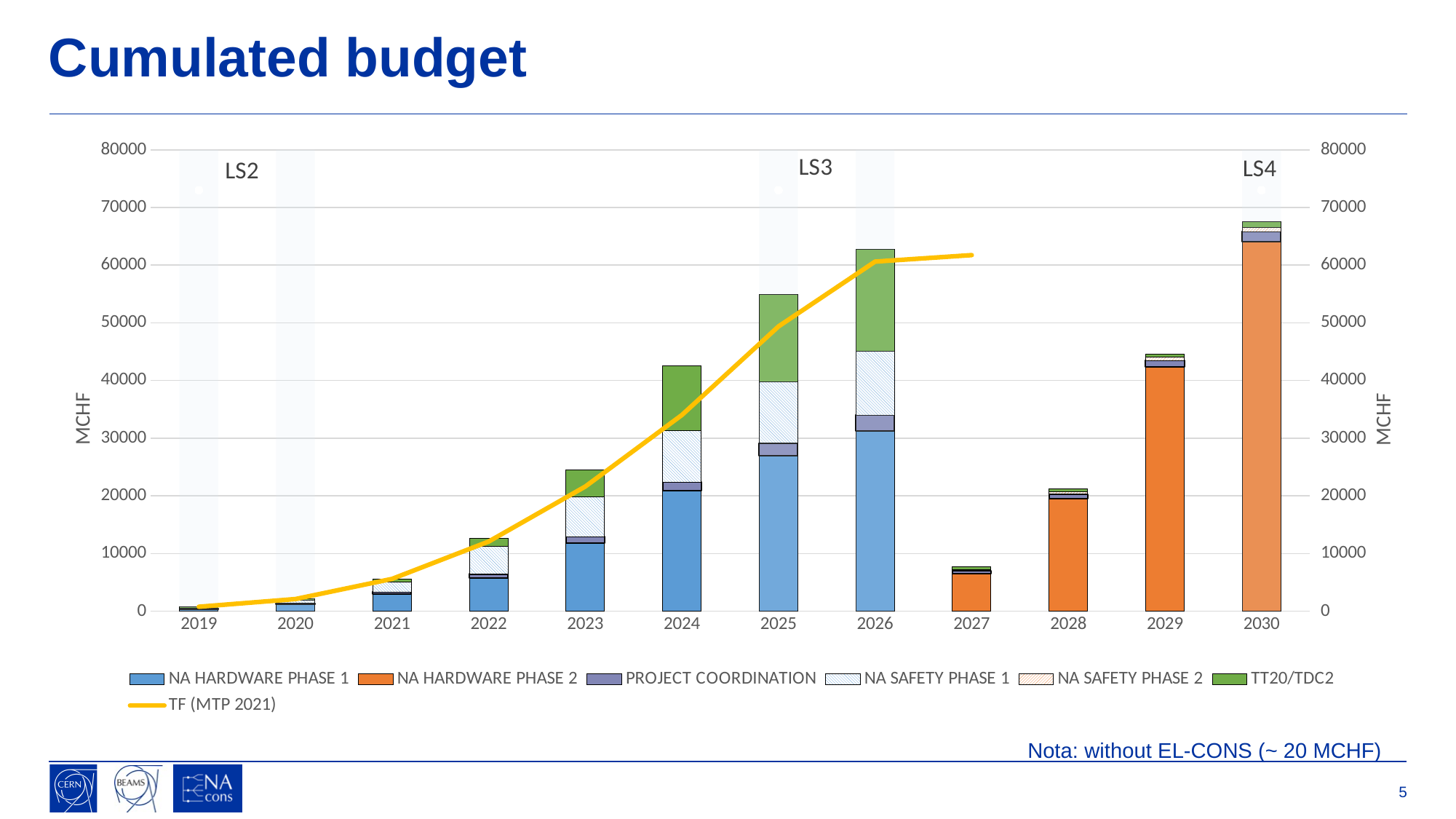
What is the label on the vertical axis of the chart? MCHF Which stacked bar is taller, 2026 or 2025? 2026 Which year has the shortest stacked bar? 2019 Does the TF (MTP 2021) line rise or fall from 2019 to 2027? rise Is the total of the stacked bar for 2030 greater or less than 60000? greater What kind of chart is shown on the slide? Stacked bar chart with a line Which year has the tallest stacked bar? 2030 Is the total of the stacked bar for 2027 greater or less than 10000? less Is the total of the stacked bar for 2024 greater or less than 30000? greater How many series does the chart legend list? 7 How many years are shown on the x axis of the chart? 12